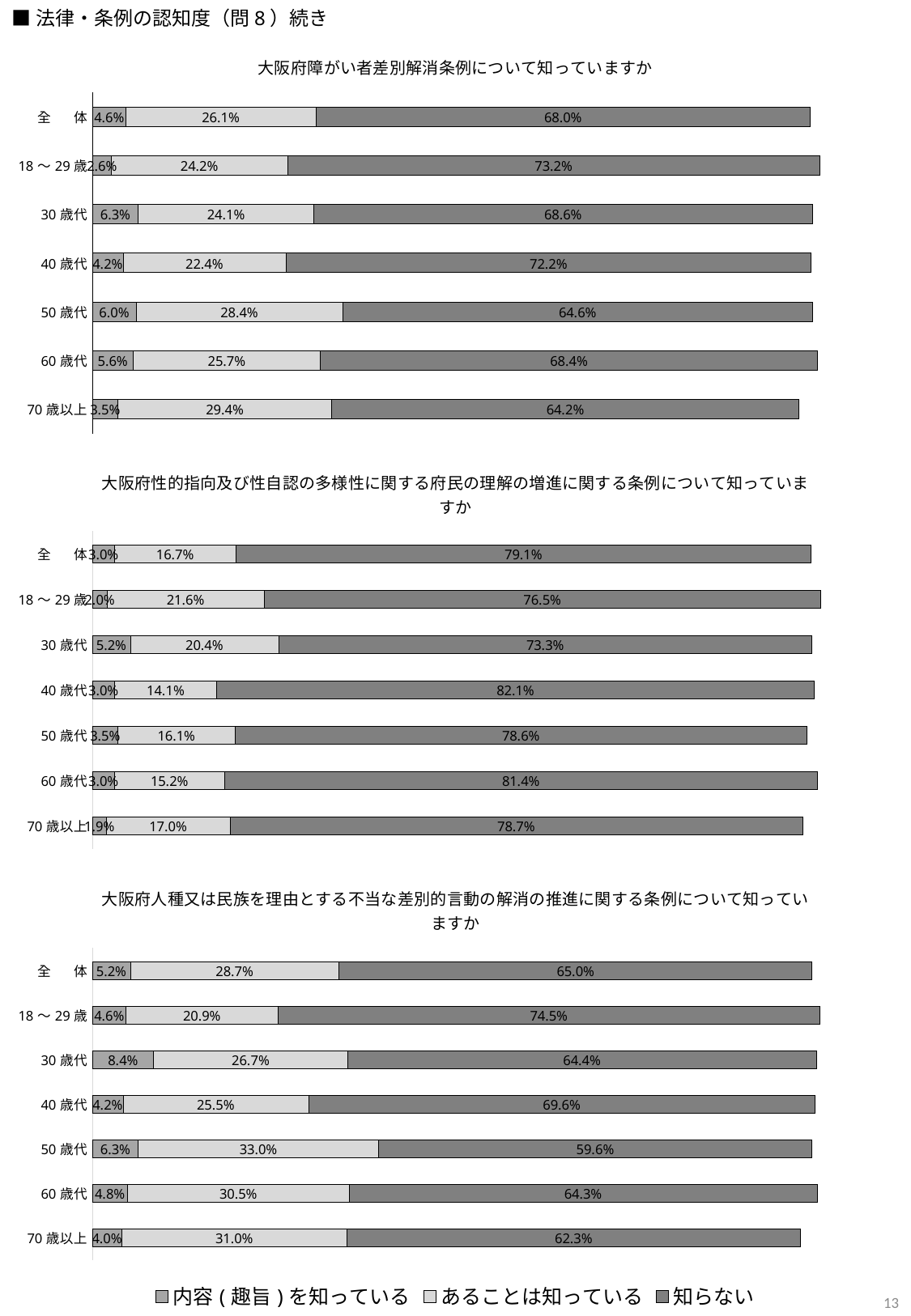
In the top chart (大阪府障がい者差別解消条例について知っていますか), which age group has the lowest 内容(趣旨)を知っている value? 18～29歳 In the top chart (大阪府障がい者差別解消条例について知っていますか), which age group has the highest 知らない value? 18～29歳 How many categories (rows) are shown in the top chart (大阪府障がい者差別解消条例について知っていますか)? 7 In the middle chart (大阪府性的指向及び性自認の多様性に関する府民の理解の増進に関する条例について知っていますか), what is the difference between the 知らない values for 40歳代 and 30歳代? 8.8% In the middle chart (大阪府性的指向及び性自認の多様性に関する府民の理解の増進に関する条例について知っていますか), which age group has the highest 知らない value? 40歳代 How many series does the legend at the bottom of the slide list? 3 What kind of chart is the middle chart (大阪府性的指向及び性自認の多様性に関する府民の理解の増進に関する条例について知っていますか)? Stacked bar chart In the bottom chart (大阪府人種又は民族を理由とする不当な差別的言動の解消の推進に関する条例について知っていますか), what is the value of 内容(趣旨)を知っている for 30歳代? 8.4% In the bottom chart (大阪府人種又は民族を理由とする不当な差別的言動の解消の推進に関する条例について知っていますか), which age group has the lowest 知らない value? 50歳代 In the top chart (大阪府障がい者差別解消条例について知っていますか), what is the value of 知らない for 全体? 68.0% In the bottom chart (大阪府人種又は民族を理由とする不当な差別的言動の解消の推進に関する条例について知っていますか), which is larger: the あることは知っている value for 50歳代 or for 18～29歳? 50歳代 In the middle chart (大阪府性的指向及び性自認の多様性に関する府民の理解の増進に関する条例について知っていますか), what is the value of あることは知っている for 30歳代? 20.4%